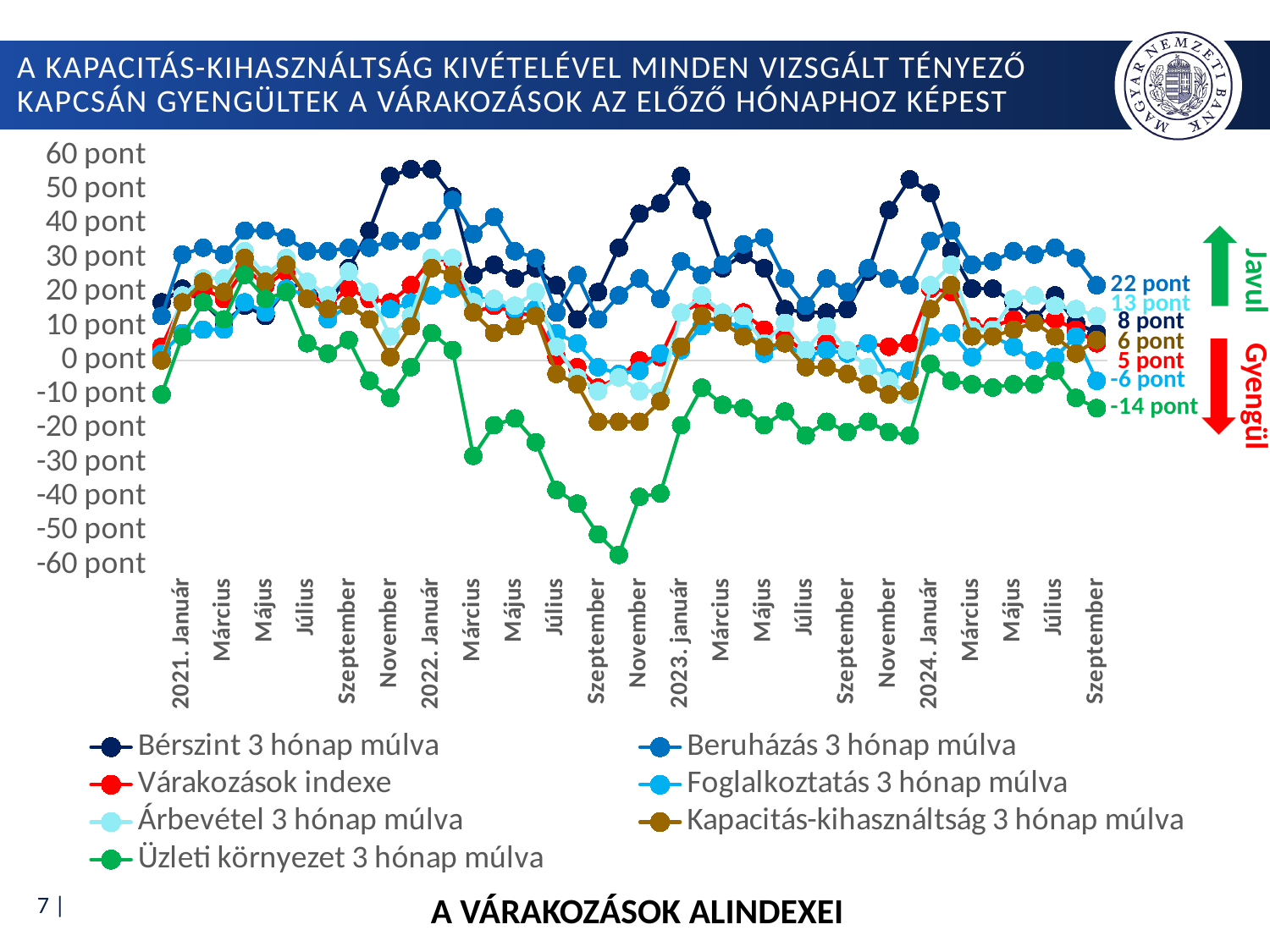
What is the latest value shown for Várakozások indexe? 5 pont What is the latest value shown for Üzleti környezet 3 hónap múlva? -14 pont How many series does the legend list? 7 At the end of the chart, which is larger: the value for Bérszint 3 hónap múlva or the value for Kapacitás-kihasználtság 3 hónap múlva? Bérszint 3 hónap múlva Which series has the highest value at the end of the chart (September 2024)? Beruházás 3 hónap múlva What is the difference between the latest values of Beruházás 3 hónap múlva (22 pont) and Árbevétel 3 hónap múlva (13 pont)? 9 pont What type of chart is shown on the slide? Line chart Which series has the lowest value at the end of the chart (September 2024)? Üzleti környezet 3 hónap múlva What is the latest value shown for Beruházás 3 hónap múlva? 22 pont What is the title of the chart shown at the bottom of the slide? A VÁRAKOZÁSOK ALINDEXEI What is the latest value shown for Foglalkoztatás 3 hónap múlva? -6 pont Is the lowest point of the Üzleti környezet 3 hónap múlva series (around October 2022) greater or less than -50 pont? less